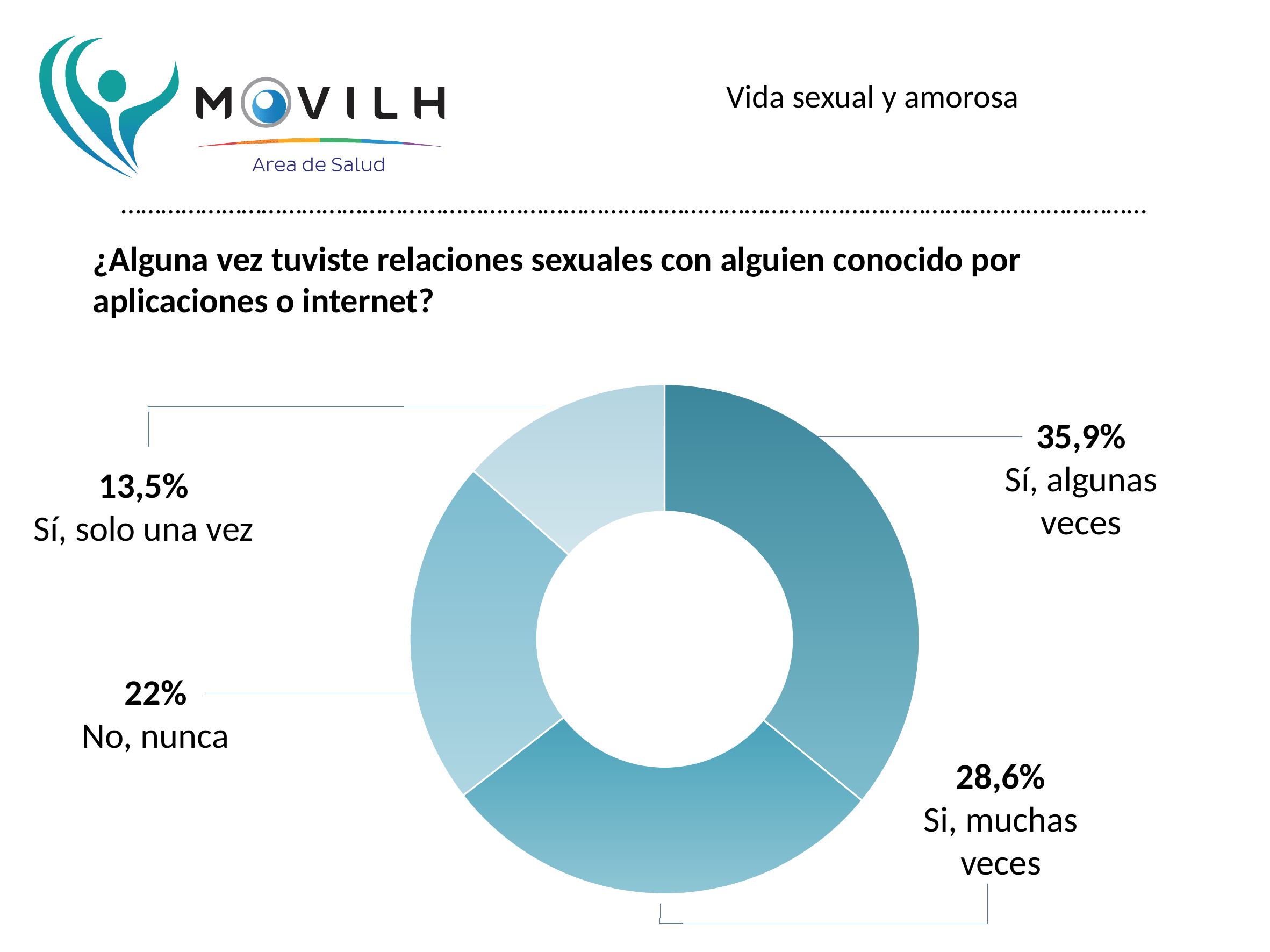
Which response category has the largest share? Sí, algunas veces What percentage of respondents answered "Si, muchas veces"? 28,6% What percentage of respondents answered "Sí, solo una vez"? 13,5% What question does the chart on the slide answer? ¿Alguna vez tuviste relaciones sexuales con alguien conocido por aplicaciones o internet? How many response categories are shown in the chart? 4 What is the difference in percentage points between "No, nunca" and "Sí, solo una vez"? 8,5 What percentage of respondents answered "No, nunca"? 22% What is the difference in percentage points between "Sí, algunas veces" and "Si, muchas veces"? 7,3 Which is larger: the share for "No, nunca" or the share for "Si, muchas veces"? Si, muchas veces Which response category has the smallest share? Sí, solo una vez What kind of chart is shown on the slide? Doughnut (pie) chart What percentage of respondents answered "Sí, algunas veces"? 35,9%